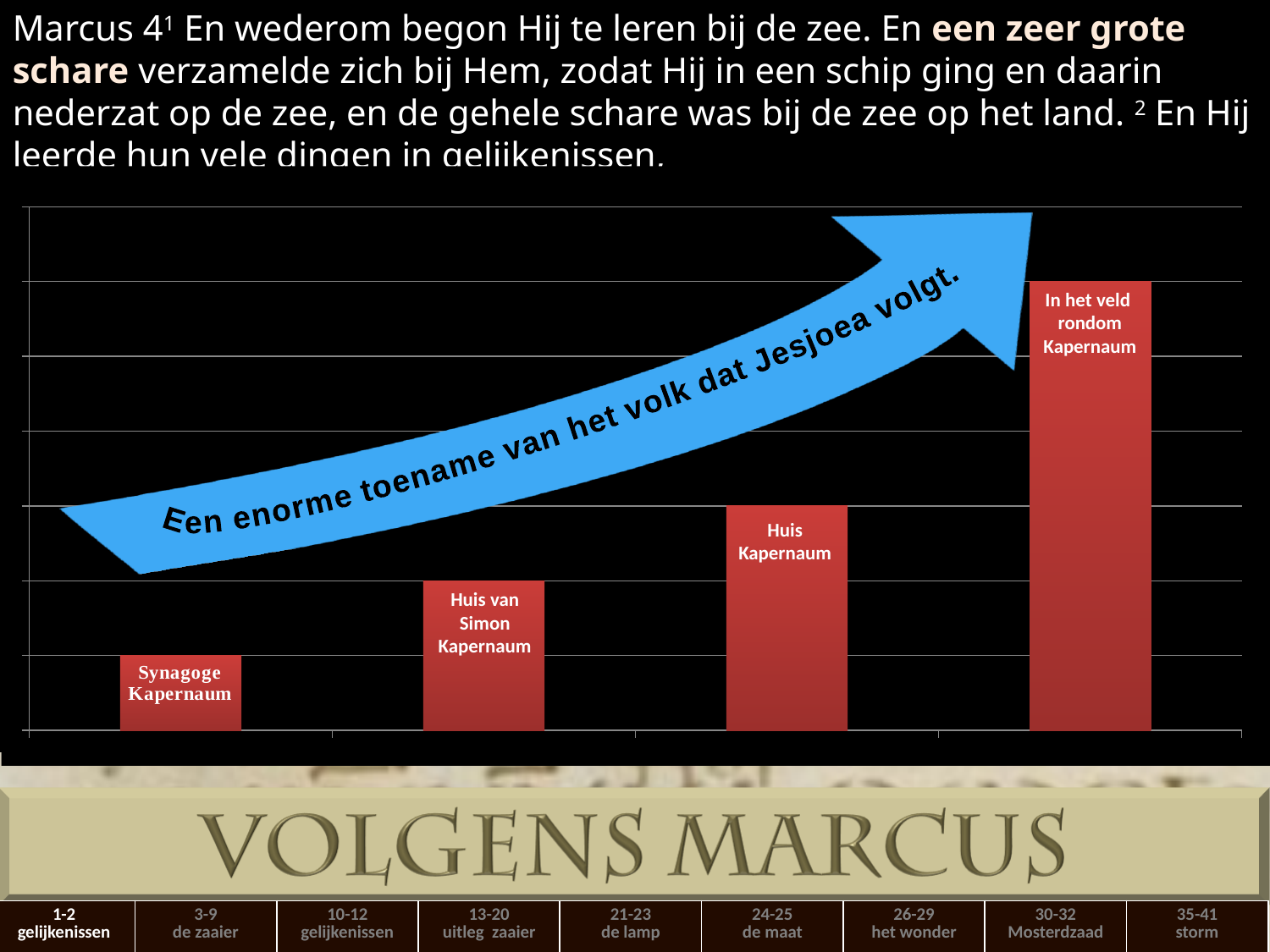
What kind of chart is shown on the slide? bar chart What is the label on the second bar from the left? Huis van Simon Kapernaum Which bar is the shortest in the chart? Synagoge Kapernaum Which bar is taller: 'Synagoge Kapernaum' or 'In het veld rondom Kapernaum'? In het veld rondom Kapernaum Which bar is the tallest in the chart? In het veld rondom Kapernaum What colour are the bars in the chart? red What text is written along the blue arrow over the chart? Een enorme toename van het volk dat Jesjoea volgt. Do the bar heights rise or fall from left to right across the chart? rise Which bar is taller: 'Huis van Simon Kapernaum' or 'Huis Kapernaum'? Huis Kapernaum What is the label on the third bar from the left? Huis Kapernaum How many bars does the chart contain? 4